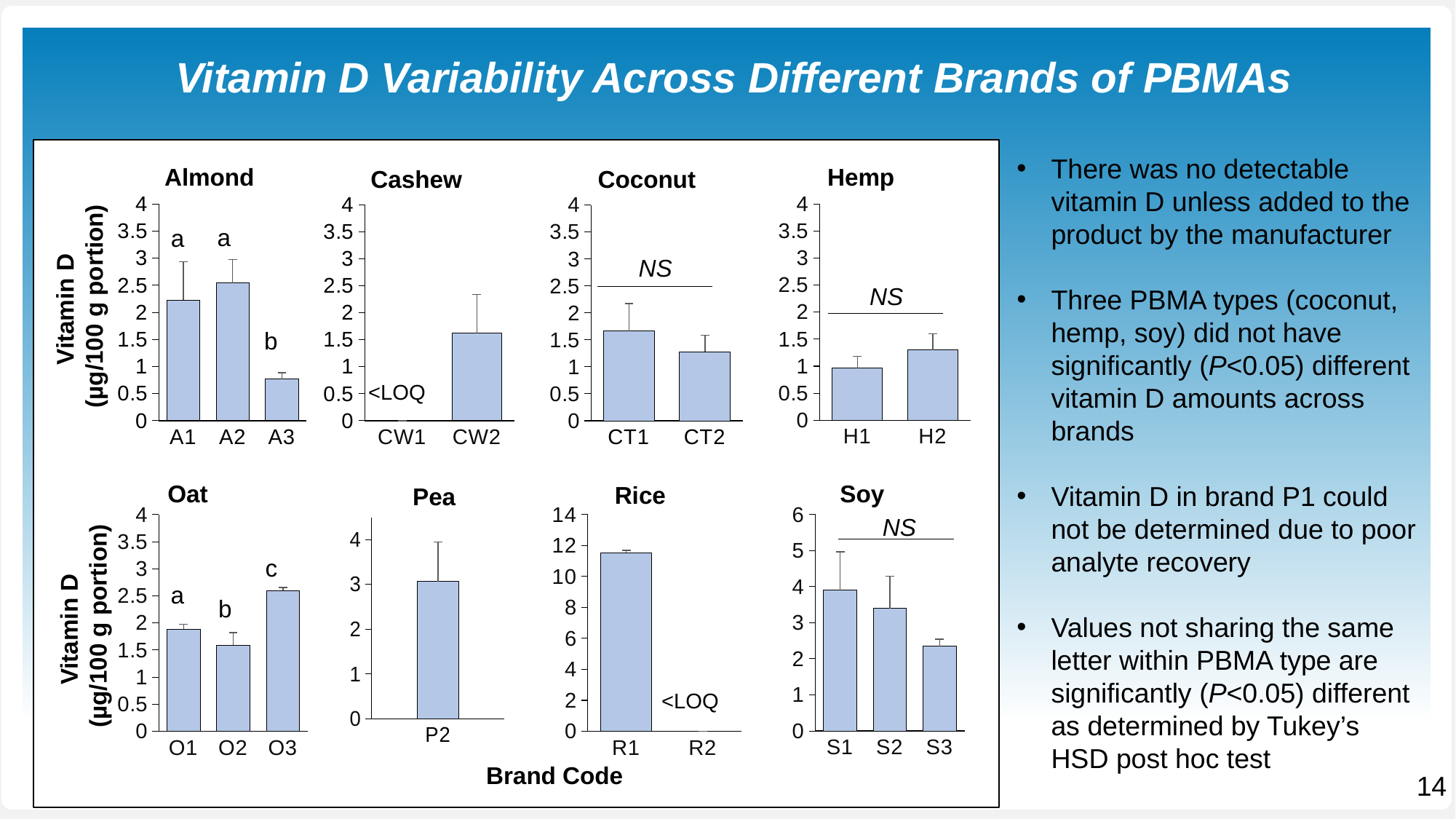
How many brands are shown in the Soy chart? 3 In the Almond chart, is the value for A3 greater or less than 1? less In the Soy chart, do the vitamin D values rise or fall from S1 to S3? fall In the Cashew chart, which brand is marked as <LOQ? CW1 In the Almond chart, which brand has the lowest vitamin D value? A3 In the Oat chart, which brand has the highest vitamin D value? O3 What kind of chart is the Almond chart? bar chart In the Hemp chart, which brand has the larger vitamin D value, H1 or H2? H2 In the Pea chart, is the value for P2 greater or less than 2? greater In the Oat chart, which brand has the lowest vitamin D value? O2 In the Coconut chart, which brand has the larger vitamin D value, CT1 or CT2? CT1 In the Rice chart, is the value for R1 greater or less than 10? greater